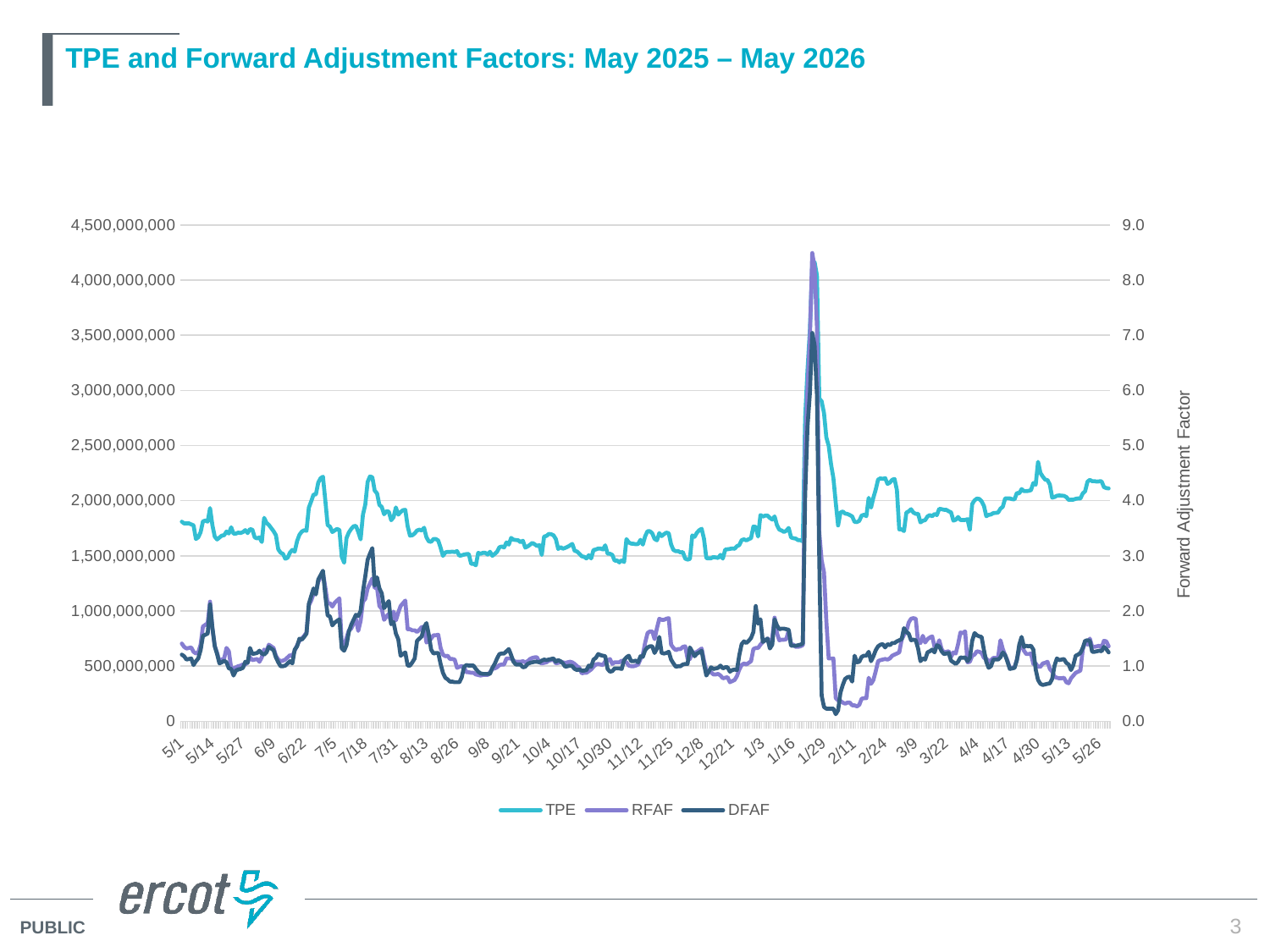
How many series does the legend list? 3 Is the peak value of TPE around 1/29 greater or less than 4,000,000,000? greater What is the title of the right-hand vertical axis? Forward Adjustment Factor Is the value of TPE at 5/1 greater or less than 1,500,000,000? greater Is the peak value of DFAF around 1/29 greater or less than 6.0 on the right axis? greater What are the three series named in the legend? TPE, RFAF, DFAF What kind of chart is shown on the slide? line chart Which series reaches the higher peak on the right axis around 1/29, RFAF or DFAF? RFAF Does the TPE line rise or fall between its peak around 1/29 and 2/11? fall